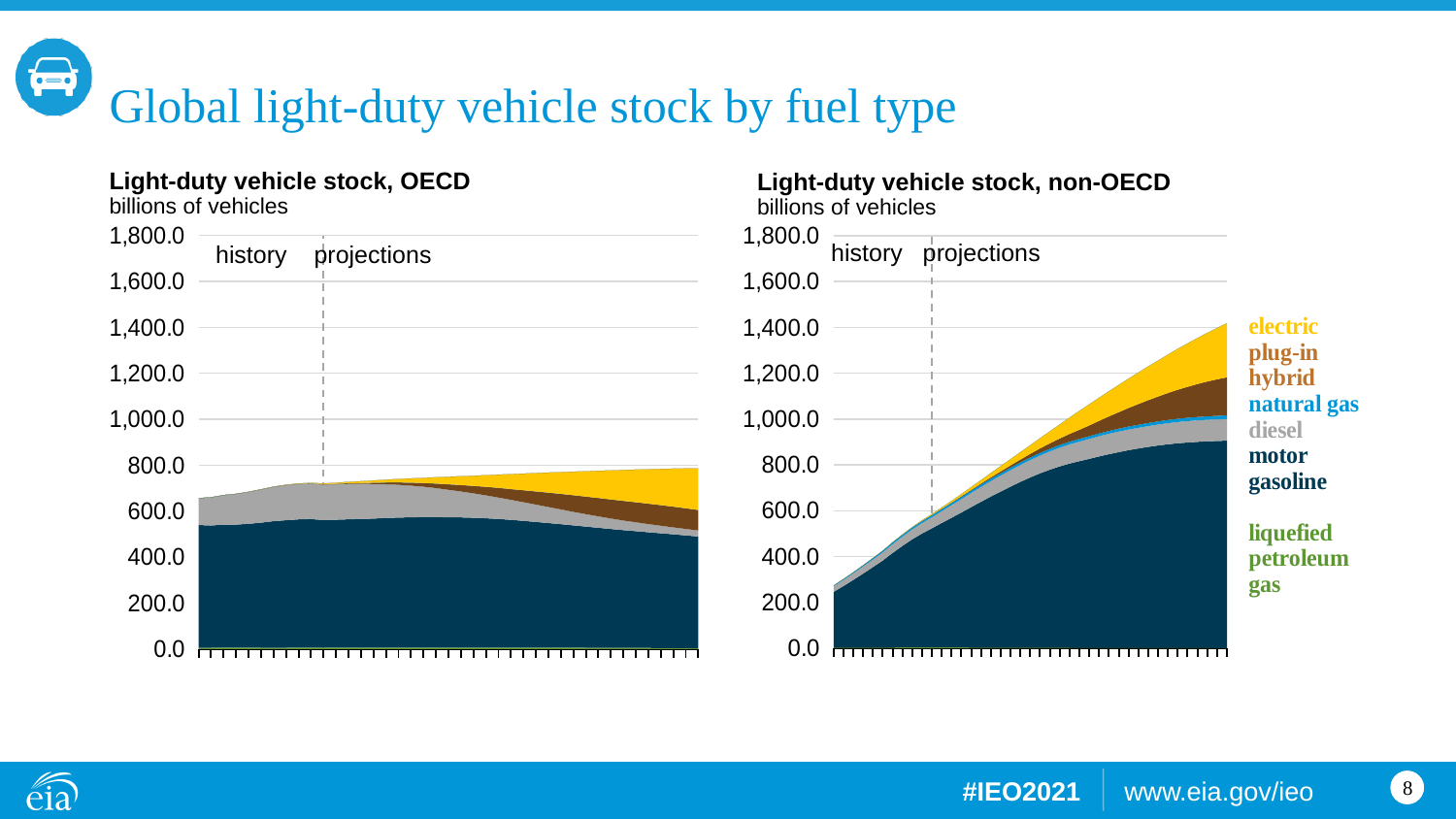
At the end of the projection period, which chart shows the larger total light-duty vehicle stock, OECD or non-OECD? non-OECD In the 'Light-duty vehicle stock, non-OECD' chart, does the total vehicle stock rise or fall over time? rise In the 'Light-duty vehicle stock, non-OECD' chart, is the total stock at the start of the history period greater or less than 400.0? less In the 'Light-duty vehicle stock, OECD' chart, is the total stock at the end of the projection period greater or less than 600.0? greater What kind of chart is the 'Light-duty vehicle stock, OECD' chart? stacked area chart What is the highest value shown on the vertical axis of the 'Light-duty vehicle stock, OECD' chart? 1,800.0 In the 'Light-duty vehicle stock, OECD' chart, is the total stock at the end of the projection period greater or less than 1,000.0? less Which fuel type accounts for the largest share of the vehicle stock in the 'Light-duty vehicle stock, OECD' chart? motor gasoline How many fuel types does the legend on the slide list? 6 What unit is shown under the title of the 'Light-duty vehicle stock, non-OECD' chart? billions of vehicles In the 'Light-duty vehicle stock, non-OECD' chart, which colour represents electric vehicles? yellow